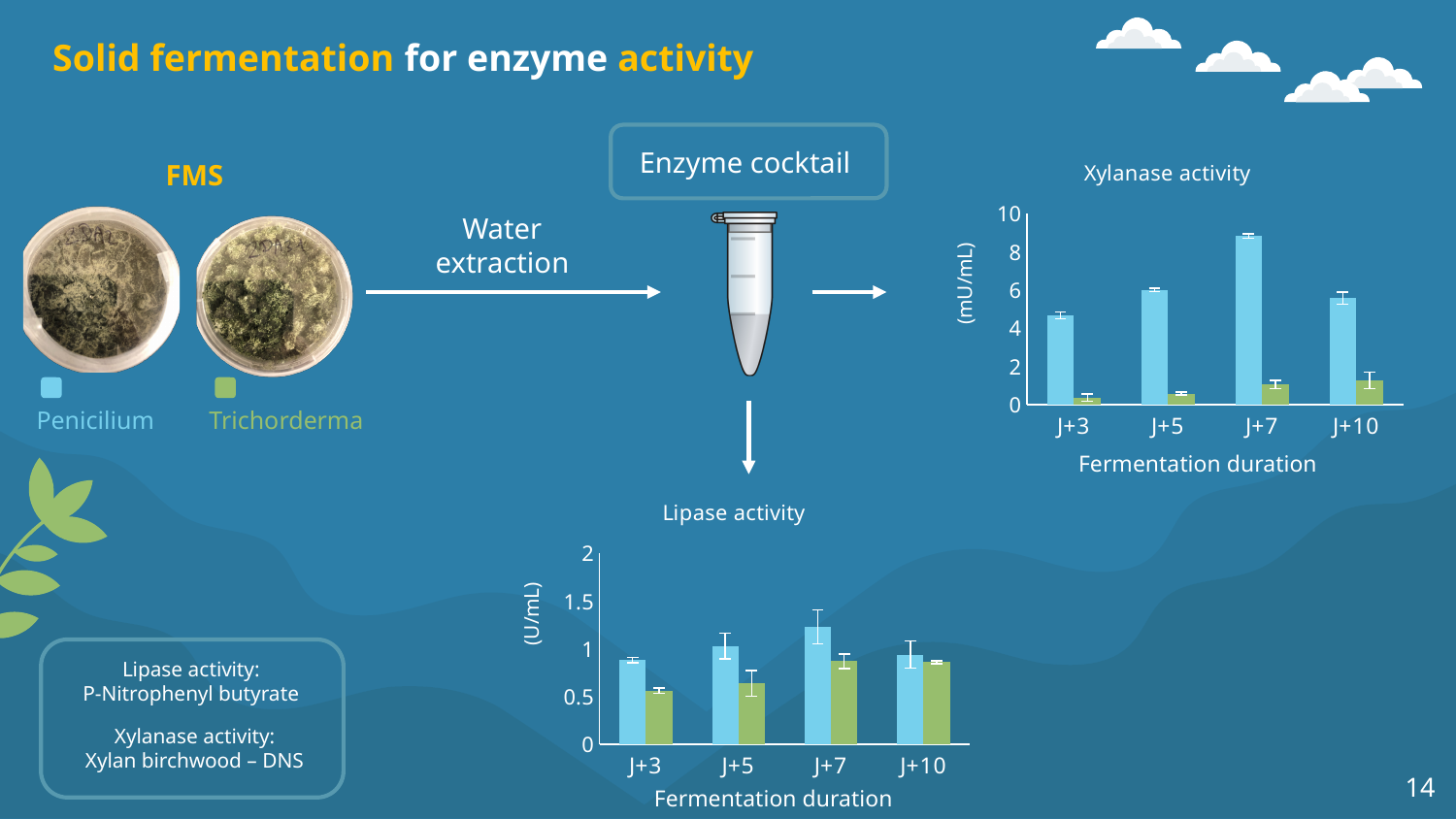
What kind of chart is the Xylanase activity chart? bar chart What is the y-axis unit label on the Lipase activity chart? (U/mL) In the Xylanase activity chart, is the Penicilium value at J+3 greater or less than 6? less In the Xylanase activity chart, at which fermentation duration is the Penicilium value lowest? J+3 In the Lipase activity chart, is the Penicilium value at J+7 greater or less than 1? greater In the Xylanase activity chart, at which fermentation duration is the Penicilium value highest? J+7 In the Lipase activity chart, at which fermentation duration is the Penicilium value highest? J+7 In the Xylanase activity chart, is the Penicilium value at J+7 greater or less than 8? greater In the Xylanase activity chart, which is larger at J+7, the Penicilium value or the Trichorderma value? Penicilium How many fermentation duration categories are shown on the x axis of the Lipase activity chart? 4 In the Xylanase activity chart, do the Trichorderma values rise or fall from J+3 to J+10? rise